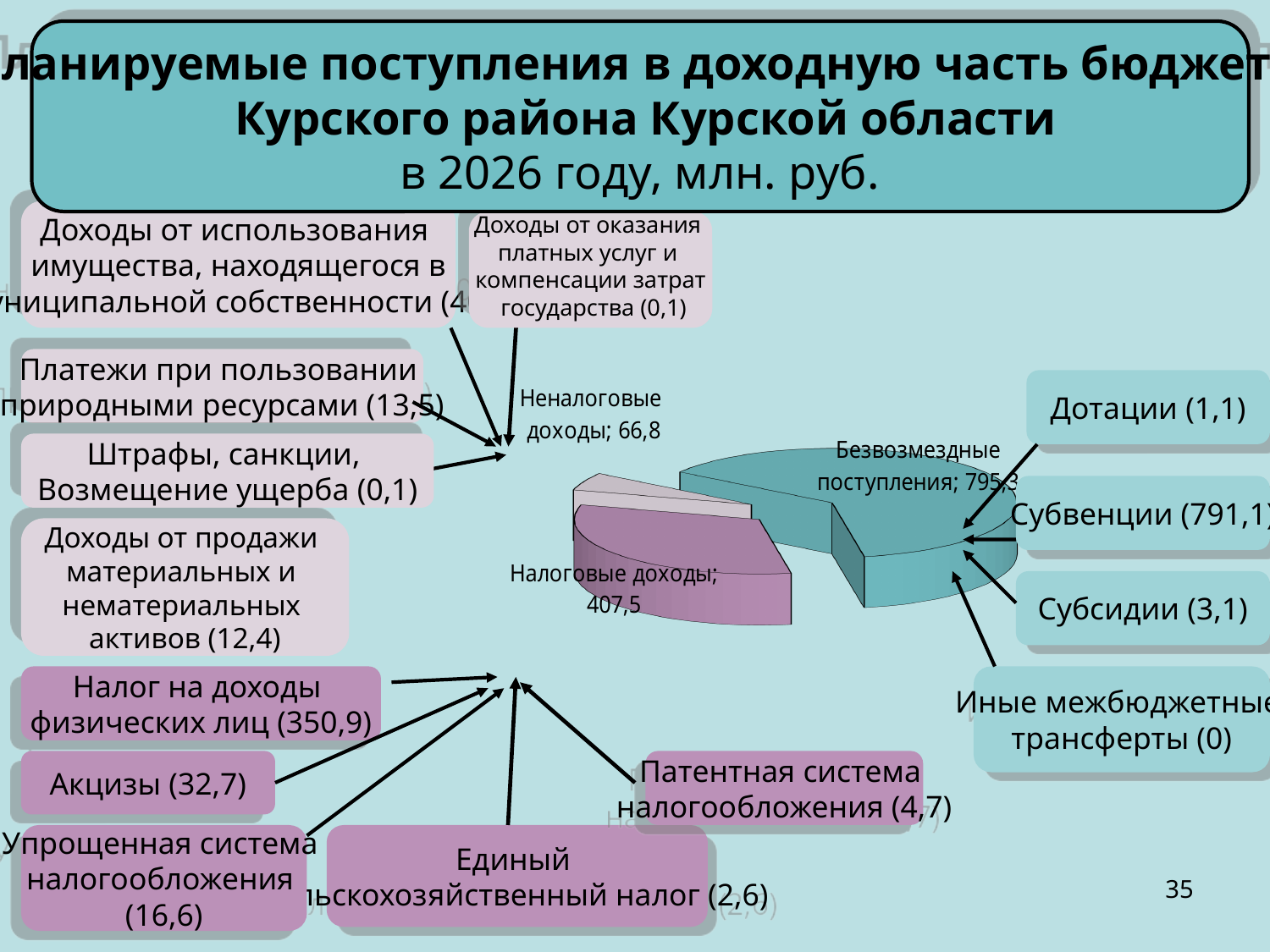
Which is larger in the pie chart: Налоговые доходы or Неналоговые доходы? Налоговые доходы What kind of chart is shown on the slide? pie chart What is the value for Неналоговые доходы in the pie chart? 66,8 Which slice of the pie chart has the largest value? Безвозмездные поступления What is the value for Налоговые доходы in the pie chart? 407,5 What is the difference between Безвозмездные поступления and Налоговые доходы in the pie chart? 387,8 What is the difference between Налоговые доходы and Неналоговые доходы in the pie chart? 340,7 For which year does the slide title say the planned revenues are shown? 2026 In what units are the values on the slide expressed, according to the title? млн. руб. How many slices does the pie chart have? 3 What is the value for Безвозмездные поступления in the pie chart? 795,3 Which slice of the pie chart has the smallest value? Неналоговые доходы